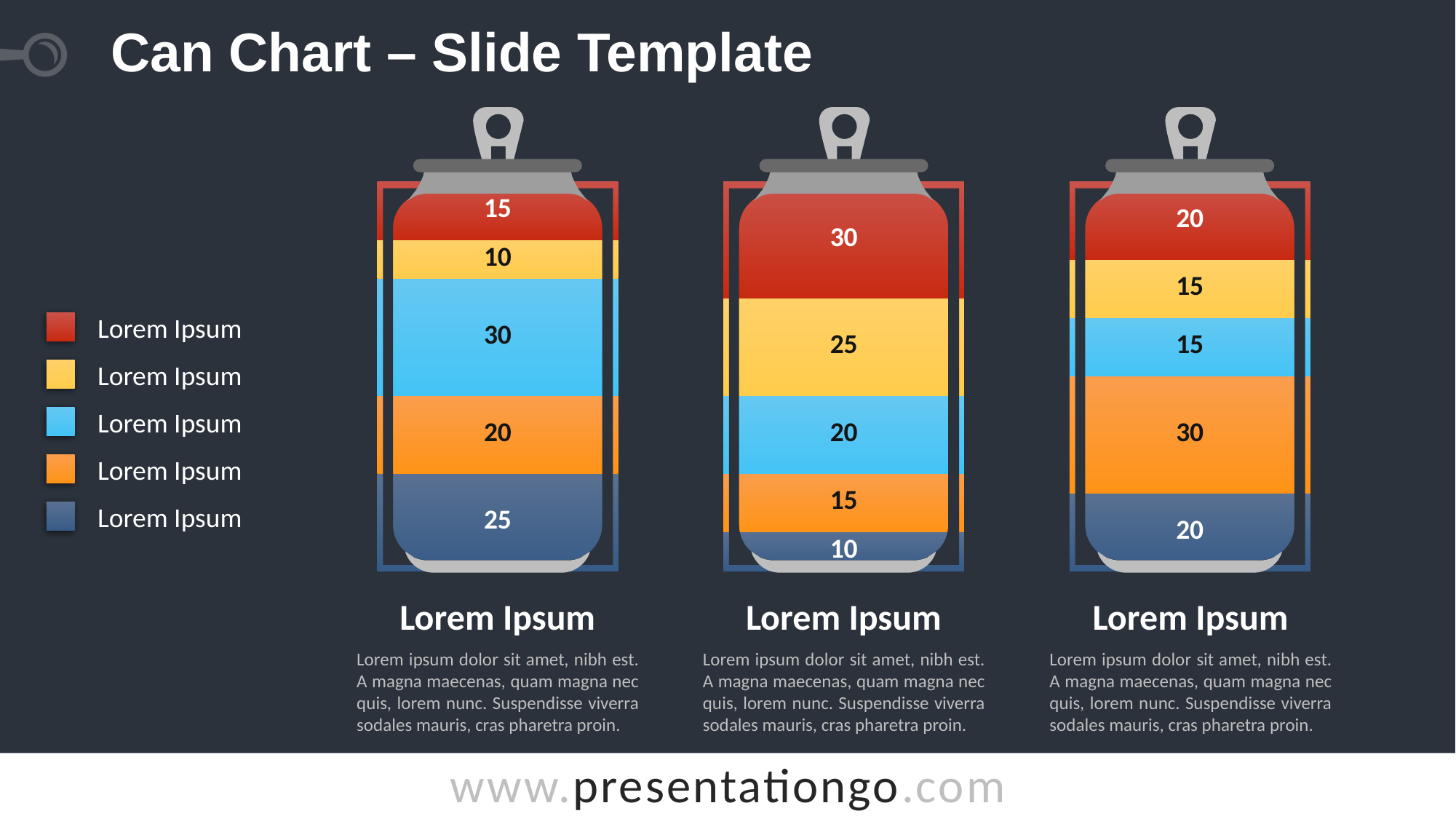
How many entries does the legend list? 5 Which is larger: the red segment in the middle can or the red segment in the right can? The red segment in the middle can (30) In the right can chart, what is the value of the orange segment? 30 In the left can chart, what is the value of the red segment at the top? 15 In the middle can chart, which segment has the largest value? The red segment (30) In the left can chart, what is the value of the dark blue segment at the bottom? 25 What is the total of all segments in the left can chart? 100 How many segments does each can chart contain? 5 In the right can chart, which segment has the largest value? The orange segment (30) In the middle can chart, what is the value of the yellow segment? 25 In the left can chart, what is the difference between the light blue segment and the yellow segment? 20 In the middle can chart, which segment has the smallest value? The dark blue segment (10)